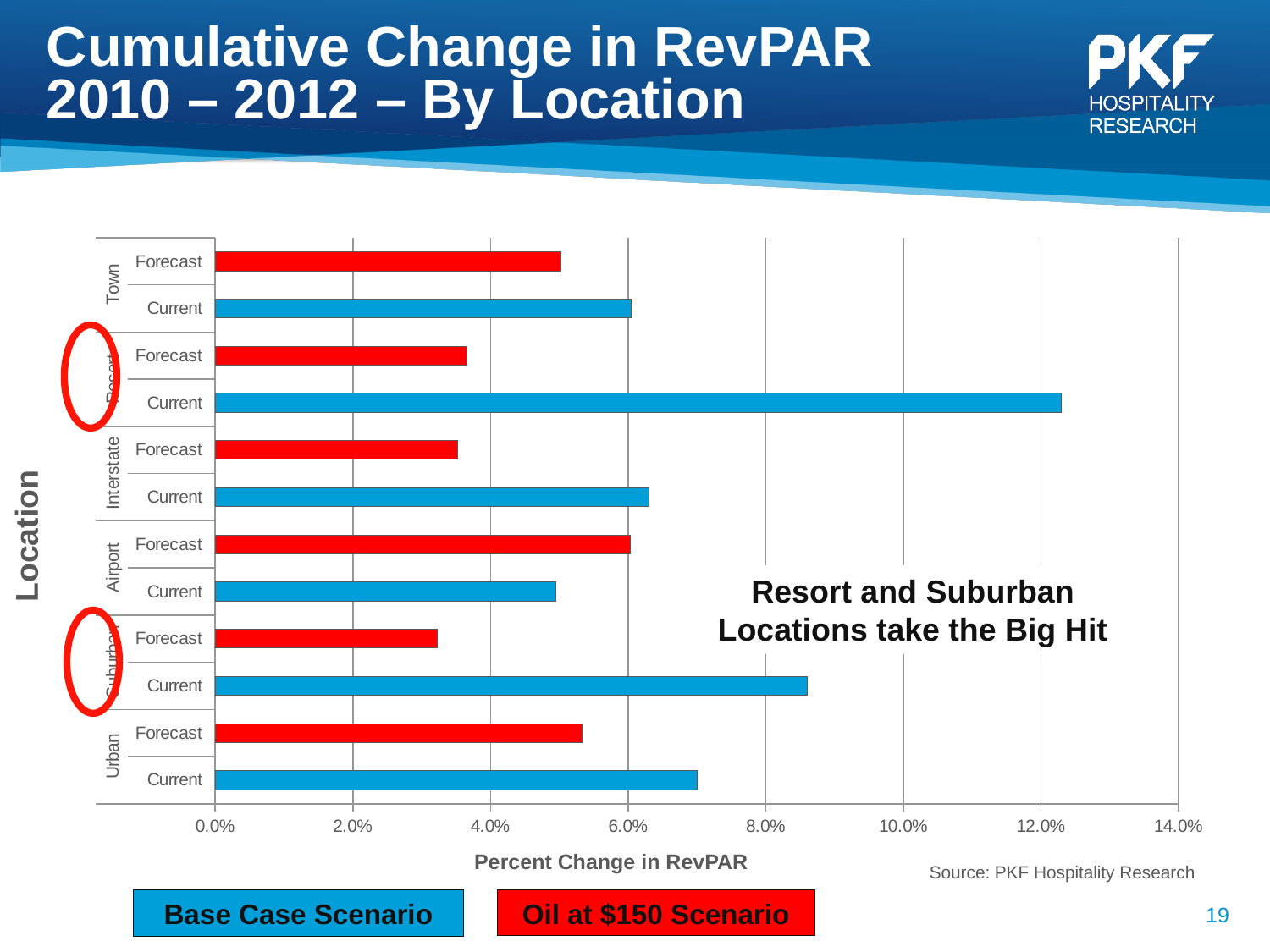
Is the Current value for Resort greater or less than 12.0%? greater Is the Current value for Suburban greater or less than 8.0%? greater What kind of chart is shown on the slide? bar chart Which location has the shortest Forecast bar? Suburban Is the Current value for Town greater or less than 4.0%? greater Which location has the longest Current bar? Resort How many locations are shown on the chart? 6 For Airport, which is larger, the Forecast value or the Current value? Forecast What does the red colour represent according to the legend? Oil at $150 Scenario